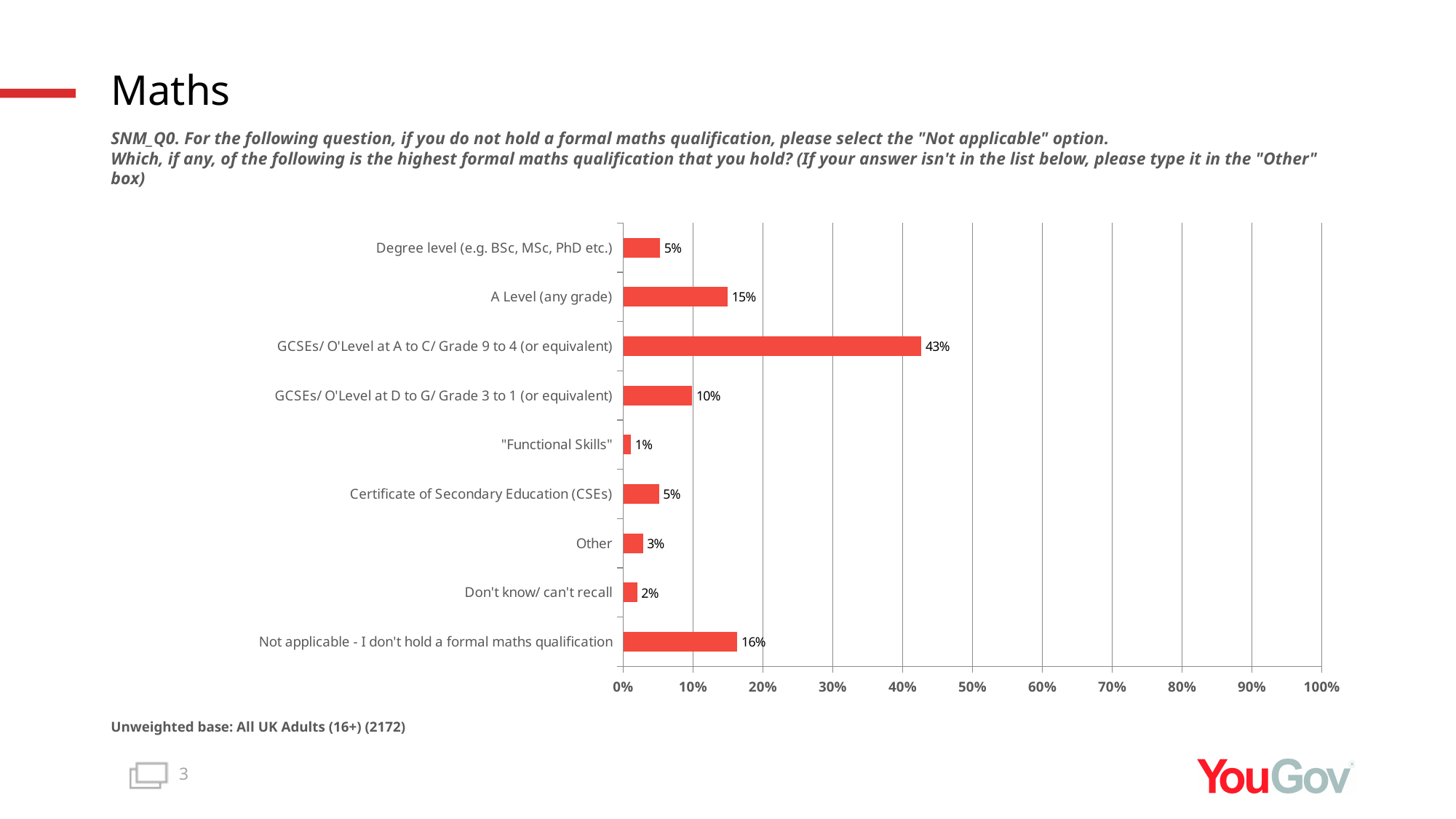
Which category has the highest value? GCSEs/ O'Level at A to C/ Grade 9 to 4 (or equivalent) Which category has the lowest value? "Functional Skills" What is the difference between the value for GCSEs/O'Level at A to C/Grade 9 to 4 and the value for A Level (any grade)? 28% What is the value for "A Level (any grade)"? 15% How many categories are shown in the chart? 9 What kind of chart is shown on the slide? Bar chart What is the difference between the value for "Degree level (e.g. BSc, MSc, PhD etc.)" and the value for "Other"? 2% What percentage selected "Not applicable - I don't hold a formal maths qualification"? 16% What is the value for "Functional Skills"? 1% What percentage of respondents hold a GCSE/O'Level at A to C/Grade 9 to 4 (or equivalent) as their highest maths qualification? 43% Which is larger: the value for "Not applicable - I don't hold a formal maths qualification" or the value for "A Level (any grade)"? Not applicable - I don't hold a formal maths qualification What is the unweighted base stated below the chart? All UK Adults (16+) (2172)